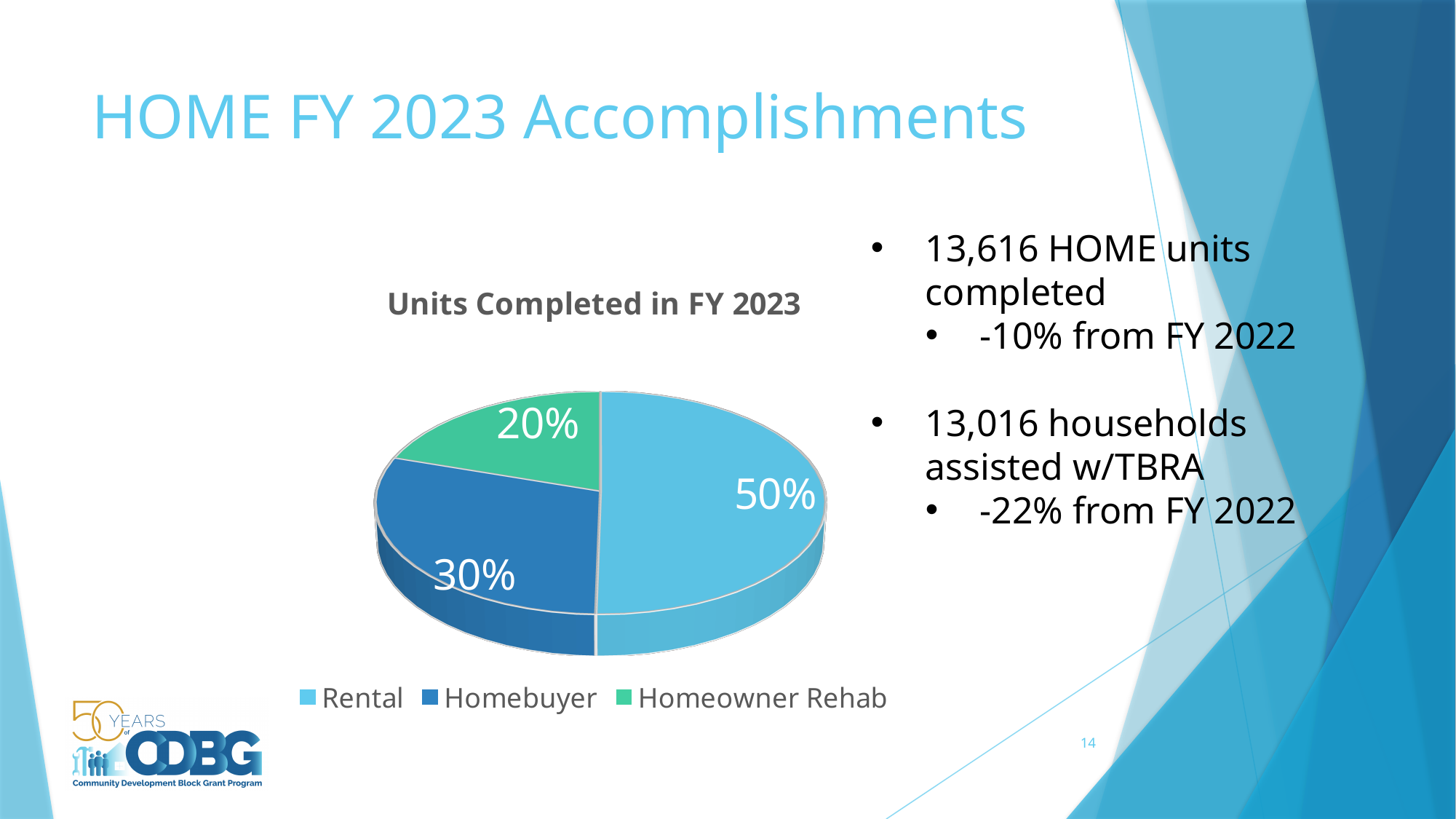
How many categories does the pie chart show? 3 Which category has the largest slice of the pie? Rental Which colour represents Homeowner Rehab in the pie chart? Green What is the difference in percentage points between the Rental and Homebuyer slices? 20 What is the title of the chart? Units Completed in FY 2023 What is the difference in percentage points between the Homebuyer and Homeowner Rehab slices? 10 Which is larger, the Homebuyer slice or the Homeowner Rehab slice? Homebuyer What kind of chart is shown on the slide? Pie chart Which category has the smallest slice of the pie? Homeowner Rehab What share of the pie does Homeowner Rehab account for? 20% What share of the pie does Homebuyer account for? 30% What share of the pie does Rental account for? 50%